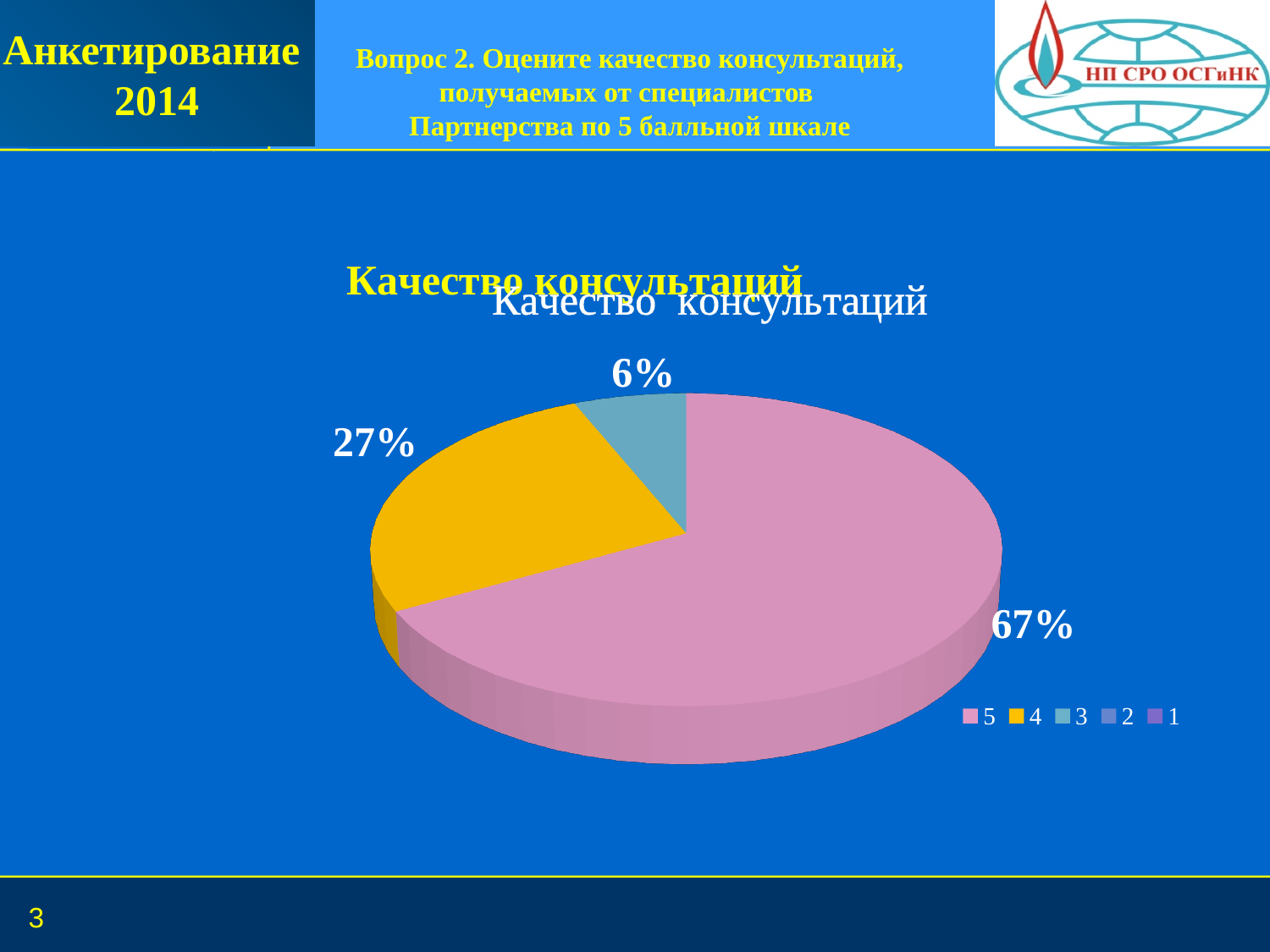
What percentage of respondents gave a rating of 3? 6% Which is larger: the share for rating 4 or the share for rating 3? 4 What is the difference in percentage points between the share for rating 5 and the share for rating 4? 40 What is the title of the chart? Качество консультаций How many slices with data labels are visible in the pie? 3 What colour is the slice for rating 4? yellow How many entries does the legend list? 5 What type of chart is shown on the slide? pie chart What percentage of respondents gave a rating of 4? 27% Which rating among those shown with a slice has the smallest share? 3 What percentage of respondents gave a rating of 5? 67% Which rating has the largest share of the pie? 5